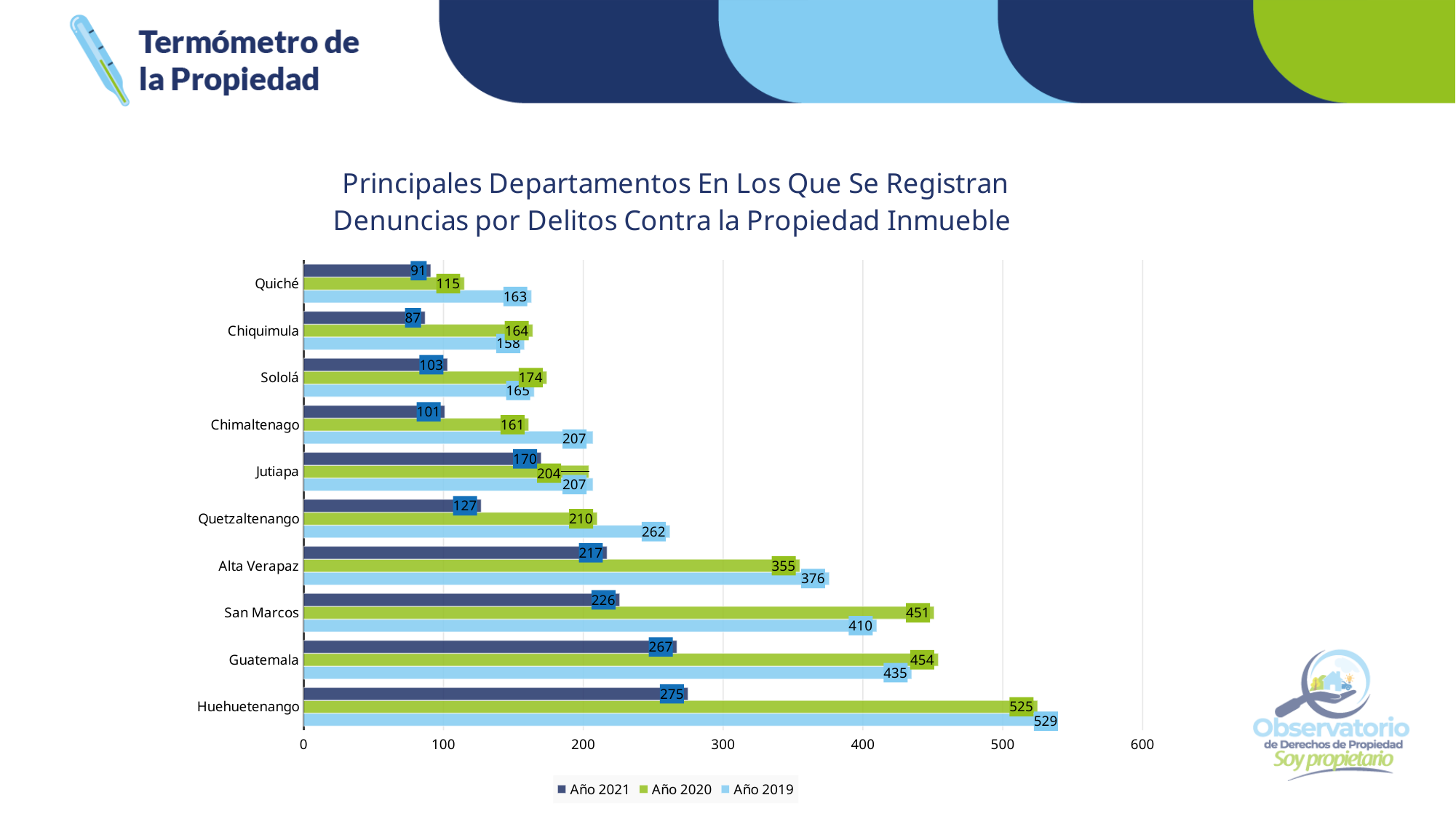
How many series does the legend list? 3 What is the difference between the Año 2020 and Año 2021 values for Guatemala? 187 Is the value for Alta Verapaz in Año 2020 greater or less than 300? greater What type of chart is shown on the slide? bar chart Which department has the lowest value in Año 2021? Chiquimula What is the value for Huehuetenango in Año 2020? 525 What is the value for Quetzaltenango in Año 2019? 262 How many departments are shown on the chart? 10 Which department has the highest value in Año 2019? Huehuetenango What is the value for Chiquimula in Año 2021? 87 Which series is shown in green in the legend? Año 2020 Which is larger for San Marcos: the Año 2020 value or the Año 2019 value? Año 2020